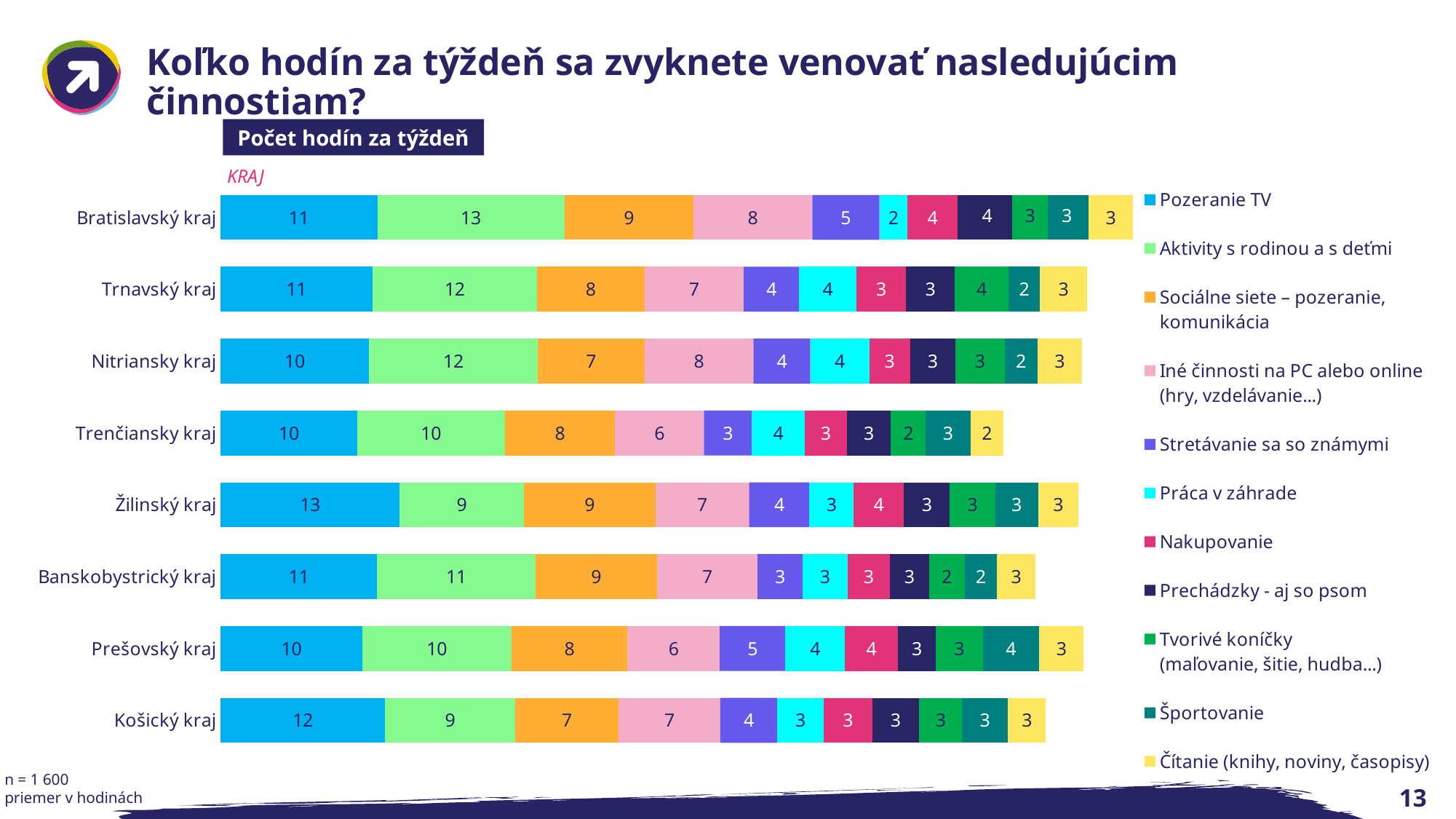
What is the value for Sociálne siete – pozeranie, komunikácia in Nitriansky kraj? 7 What is the value for Stretávanie sa so známymi in Prešovský kraj? 5 Which region has the highest value for Pozeranie TV? Žilinský kraj What is the value for Aktivity s rodinou a s deťmi in Bratislavský kraj? 13 What is the total of the stacked bar for Bratislavský kraj? 65 What is the value for Pozeranie TV in Žilinský kraj? 13 Which region has the larger value for Pozeranie TV, Košický kraj or Trnavský kraj? Košický kraj What kind of chart is shown on the slide? Stacked bar chart How many series does the legend list? 11 How many regions (kraj) are shown in the chart? 8 In Bratislavský kraj, what is the difference between Aktivity s rodinou a s deťmi and Pozeranie TV? 2 Which region has the highest value for Aktivity s rodinou a s deťmi? Bratislavský kraj